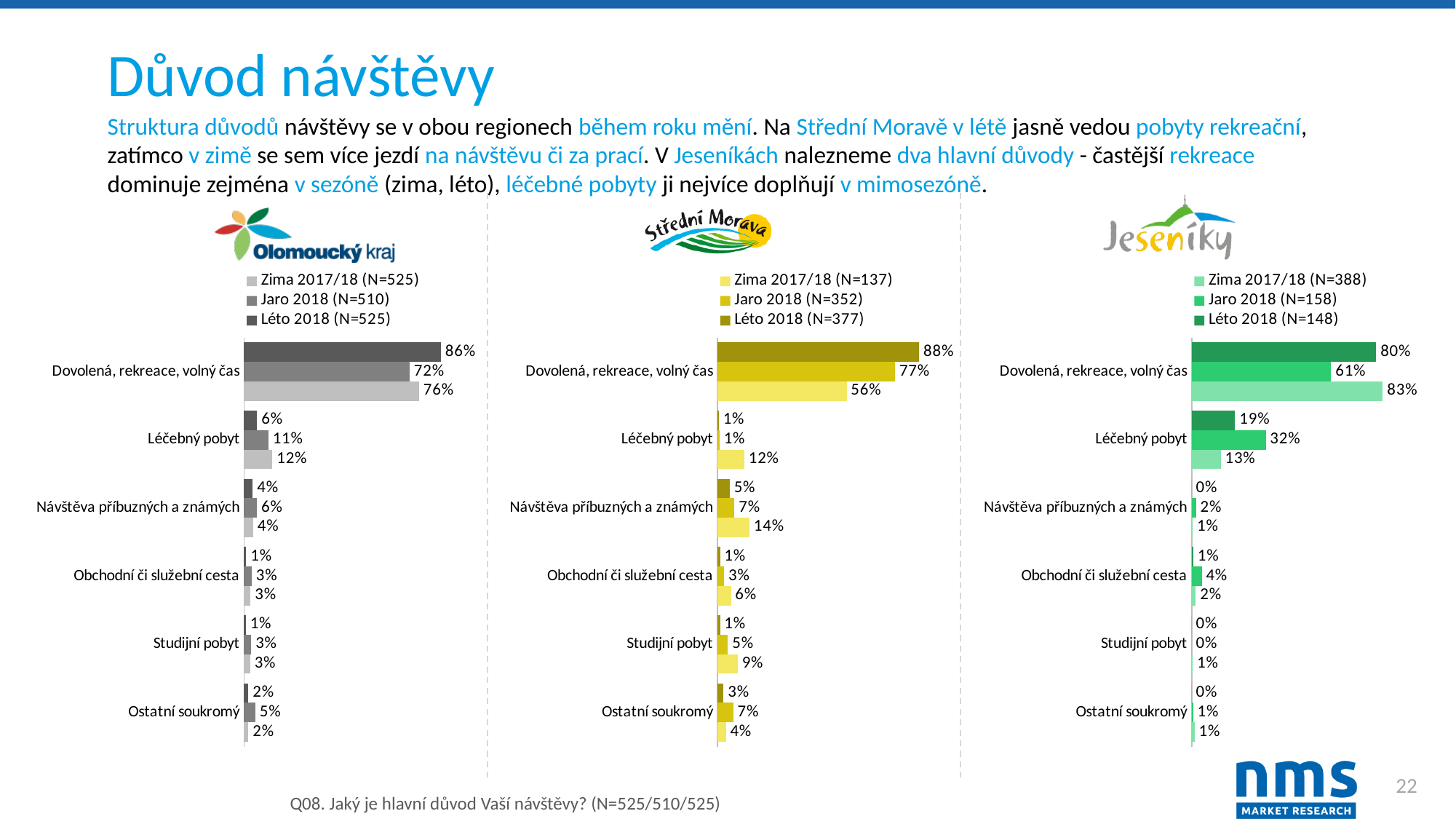
In the Jeseníky chart, which is larger for Dovolená, rekreace, volný čas: Zima 2017/18 or Jaro 2018? Zima 2017/18 In the Střední Morava chart, what is the value for Dovolená, rekreace, volný čas in Zima 2017/18? 56% What is the sample size (N) for Léto 2018 in the Jeseníky chart legend? 148 In the Olomoucký kraj chart, what is the value for Dovolená, rekreace, volný čas in Léto 2018? 86% How many series does the legend of the Jeseníky chart list? 3 What kind of chart is used for Olomoucký kraj? Bar chart In the Střední Morava chart, what is the difference between the Léto 2018 and Zima 2017/18 values for Dovolená, rekreace, volný čas? 32% In the Olomoucký kraj chart, which is larger for Léčebný pobyt: Jaro 2018 or Léto 2018? Jaro 2018 In the Střední Morava chart, what is the value for Návštěva příbuzných a známých in Zima 2017/18? 14% How many categories are shown in the Střední Morava chart? 6 In the Jeseníky chart, which category has the highest value in Zima 2017/18? Dovolená, rekreace, volný čas In the Jeseníky chart, what is the value for Léčebný pobyt in Jaro 2018? 32%